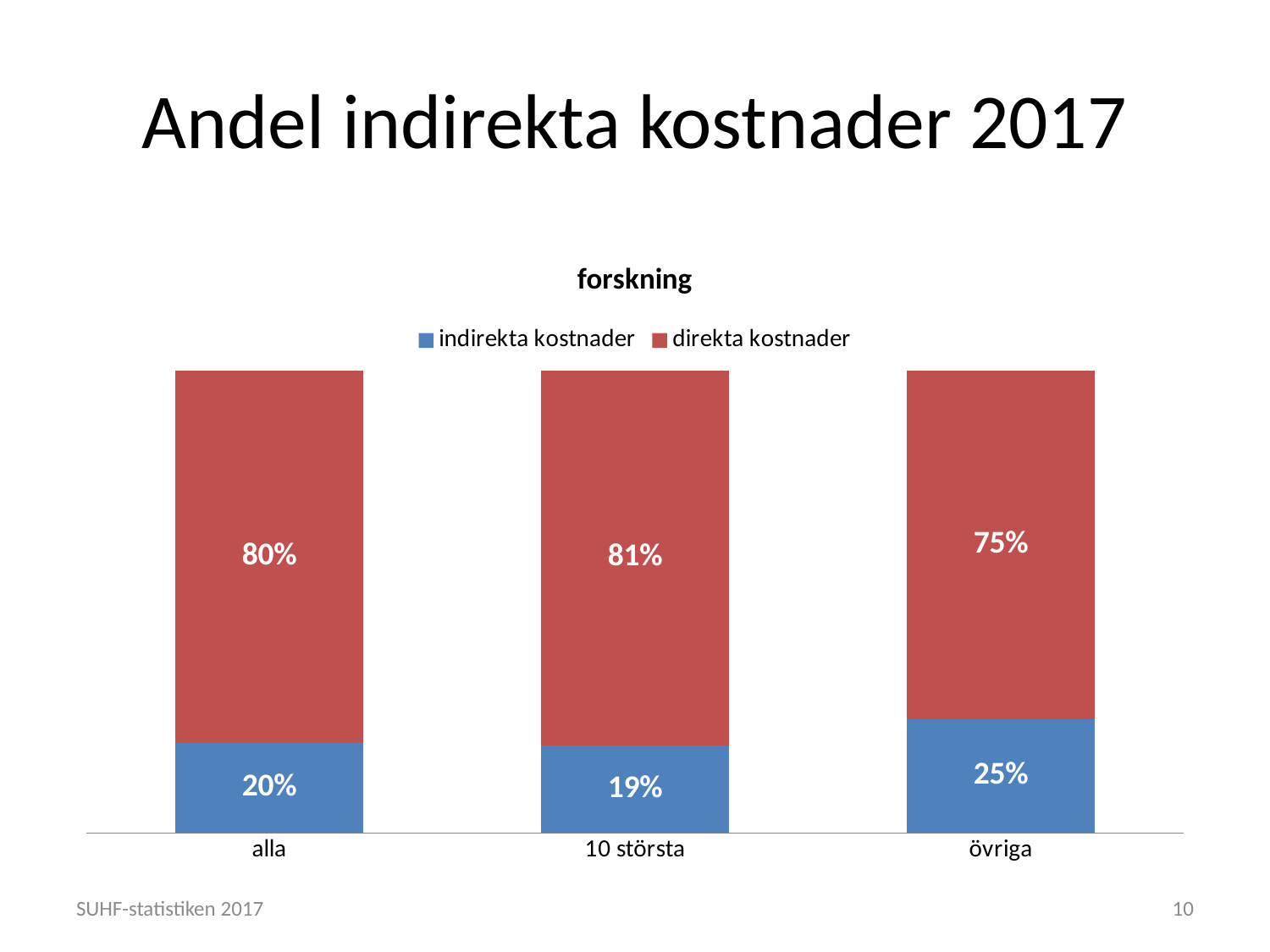
How many categories are shown on the x axis? 3 What is the difference between the indirekta kostnader share for övriga and for 10 största? 6% What is the value of direkta kostnader for 10 största? 81% What kind of chart is shown on the slide? stacked bar chart What is the value of indirekta kostnader for alla? 20% Which category has the lowest share of direkta kostnader? övriga How many series does the legend list? 2 Which is larger: the indirekta kostnader share for alla or for övriga? övriga Which category has the highest share of indirekta kostnader? övriga What is the title of the chart? forskning What is the value of direkta kostnader for övriga? 75% What is the value of indirekta kostnader for övriga? 25%